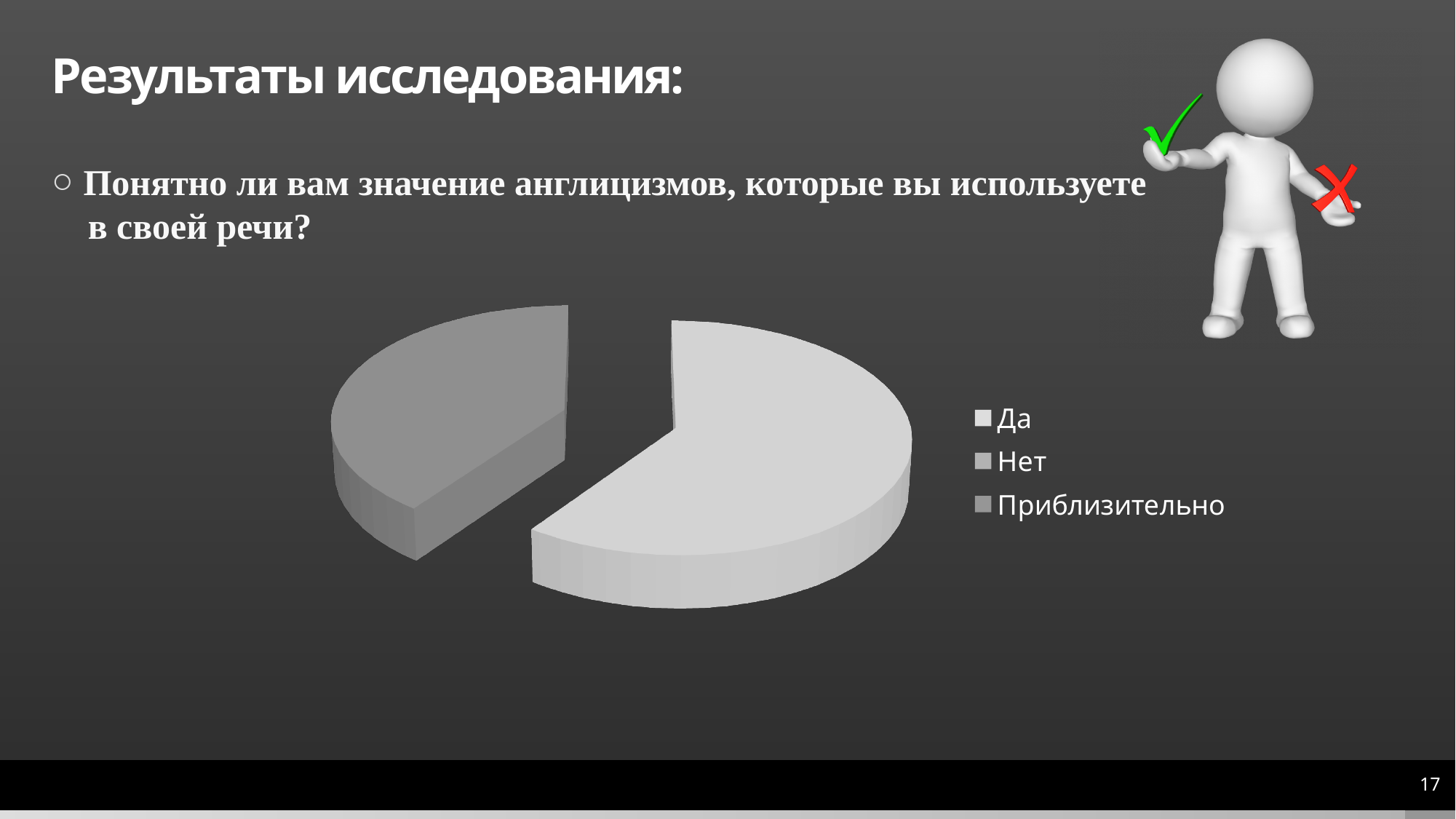
What kind of chart is shown on the slide? pie chart Which legend entry is listed first in the chart legend? Да How many entries does the chart legend list? 3 What are the three legend entries of the pie chart? Да, Нет, Приблизительно Which category has the largest slice of the pie? Да Is the share of the Да slice greater or less than 50% of the pie? greater Which survey question does the pie chart illustrate? Понятно ли вам значение англицизмов, которые вы используете в своей речи?